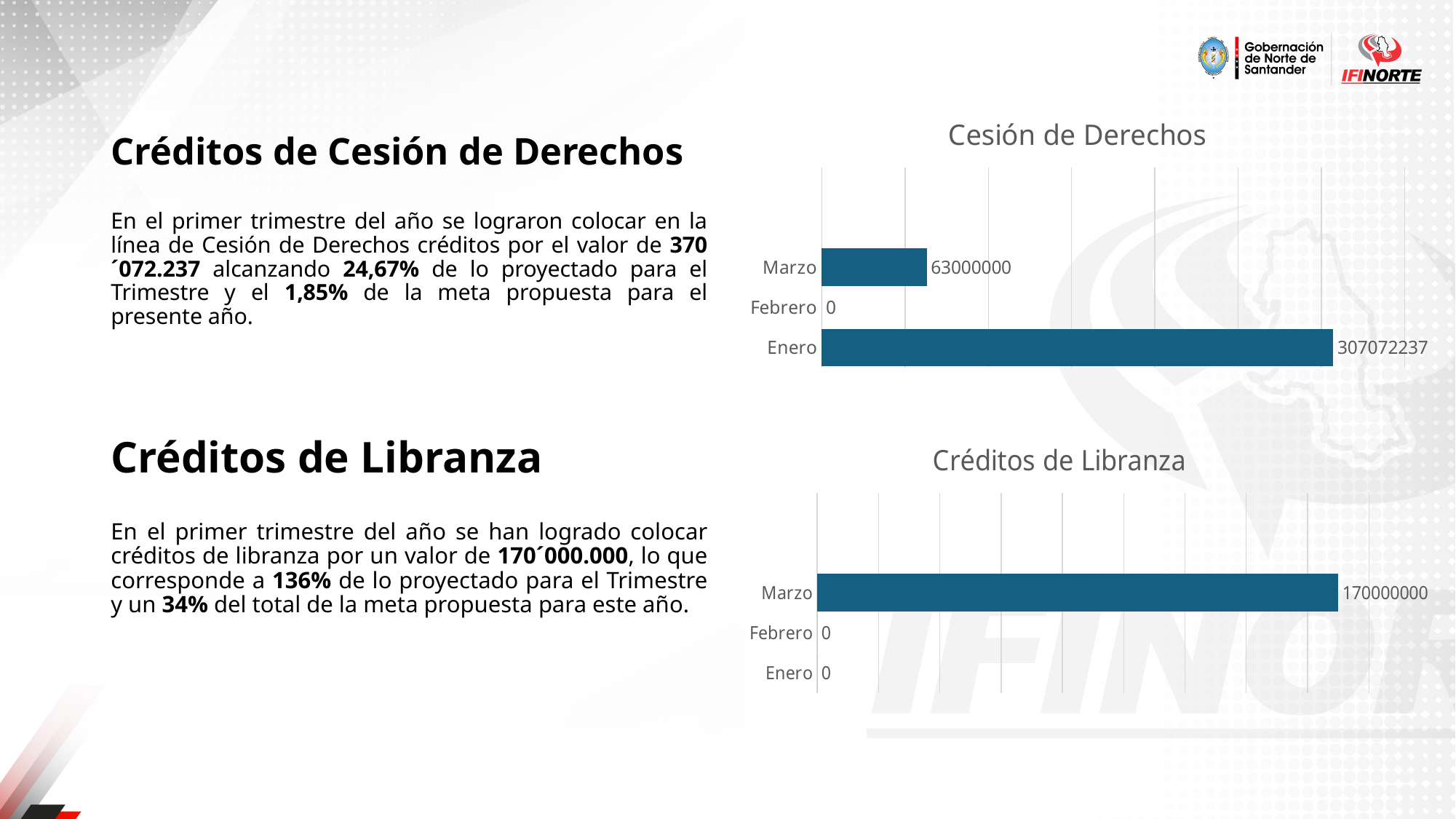
In the 'Créditos de Libranza' chart, what is the value for Enero? 0 What kind of chart is the 'Créditos de Libranza' chart? Bar chart In the 'Cesión de Derechos' chart, what is the difference between the values for Enero and Marzo? 244072237 In the 'Créditos de Libranza' chart, what is the value for Marzo? 170000000 In the 'Cesión de Derechos' chart, which month has the highest value? Enero In the 'Créditos de Libranza' chart, which month has the highest value? Marzo In the 'Cesión de Derechos' chart, what is the value for Enero? 307072237 In the 'Créditos de Libranza' chart, which is larger, the value for Marzo or the value for Febrero? Marzo In the 'Cesión de Derechos' chart, what is the value for Marzo? 63000000 In the 'Cesión de Derechos' chart, what is the value for Febrero? 0 In the 'Cesión de Derechos' chart, how many categories are shown? 3 What is the title of the top chart on the slide? Cesión de Derechos